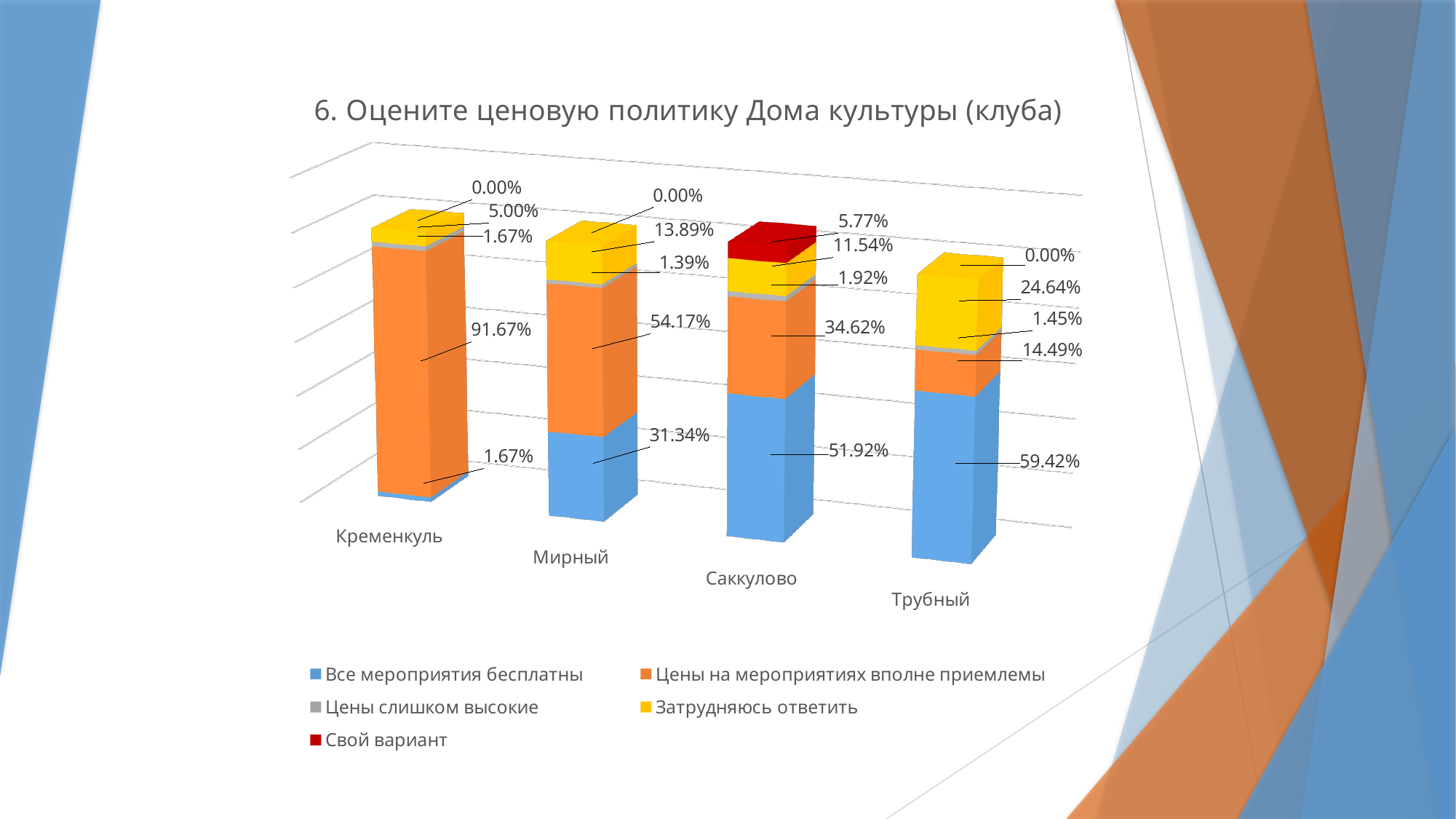
Which category has the lowest value for "Все мероприятия бесплатны"? Кременкуль What is the value for "Все мероприятия бесплатны" in Кременкуль? 1.67% What is the value for "Затрудняюсь ответить" in Трубный? 24.64% How many categories are shown on the x axis? 4 What is the difference between the "Все мероприятия бесплатны" values for Трубный and Саккулово? 7.50% What kind of chart is shown on the slide? Stacked bar chart What is the title of the chart? 6. Оцените ценовую политику Дома культуры (клуба) Which is larger: the "Затрудняюсь ответить" value for Мирный or for Саккулово? Мирный How many series does the legend list? 5 What is the value for "Свой вариант" in Саккулово? 5.77% What is the value for "Цены на мероприятиях вполне приемлемы" in Мирный? 54.17% Which category has the highest value for "Цены на мероприятиях вполне приемлемы"? Кременкуль